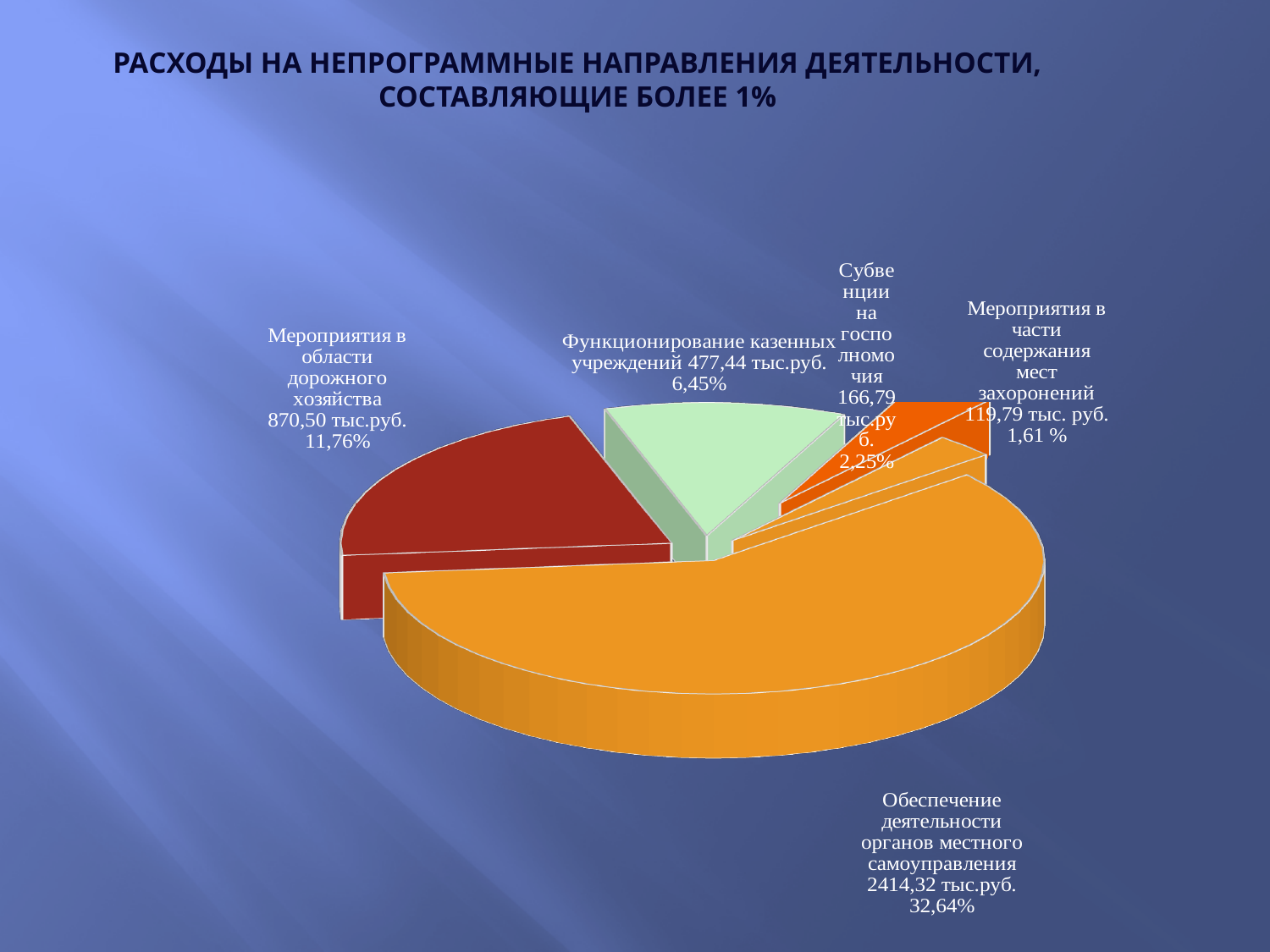
What kind of chart is shown on the slide? Pie chart What is the value for Мероприятия в области дорожного хозяйства? 870,50 тыс.руб. What is the difference between Мероприятия в области дорожного хозяйства and Функционирование казенных учреждений in тыс.руб.? 393,06 тыс.руб. Which category has the largest slice? Обеспечение деятельности органов местного самоуправления What is the value for Субвенции на госполномочия? 166,79 тыс.руб. Which category has the smallest slice? Мероприятия в части содержания мест захоронений How many slices does the pie chart have? 5 What is the value for Функционирование казенных учреждений? 477,44 тыс.руб. What is the value for Обеспечение деятельности органов местного самоуправления? 2414,32 тыс.руб. Which is larger: Мероприятия в области дорожного хозяйства or Функционирование казенных учреждений? Мероприятия в области дорожного хозяйства What percentage is shown for Обеспечение деятельности органов местного самоуправления? 32,64% What percentage is shown for Мероприятия в части содержания мест захоронений? 1,61 %